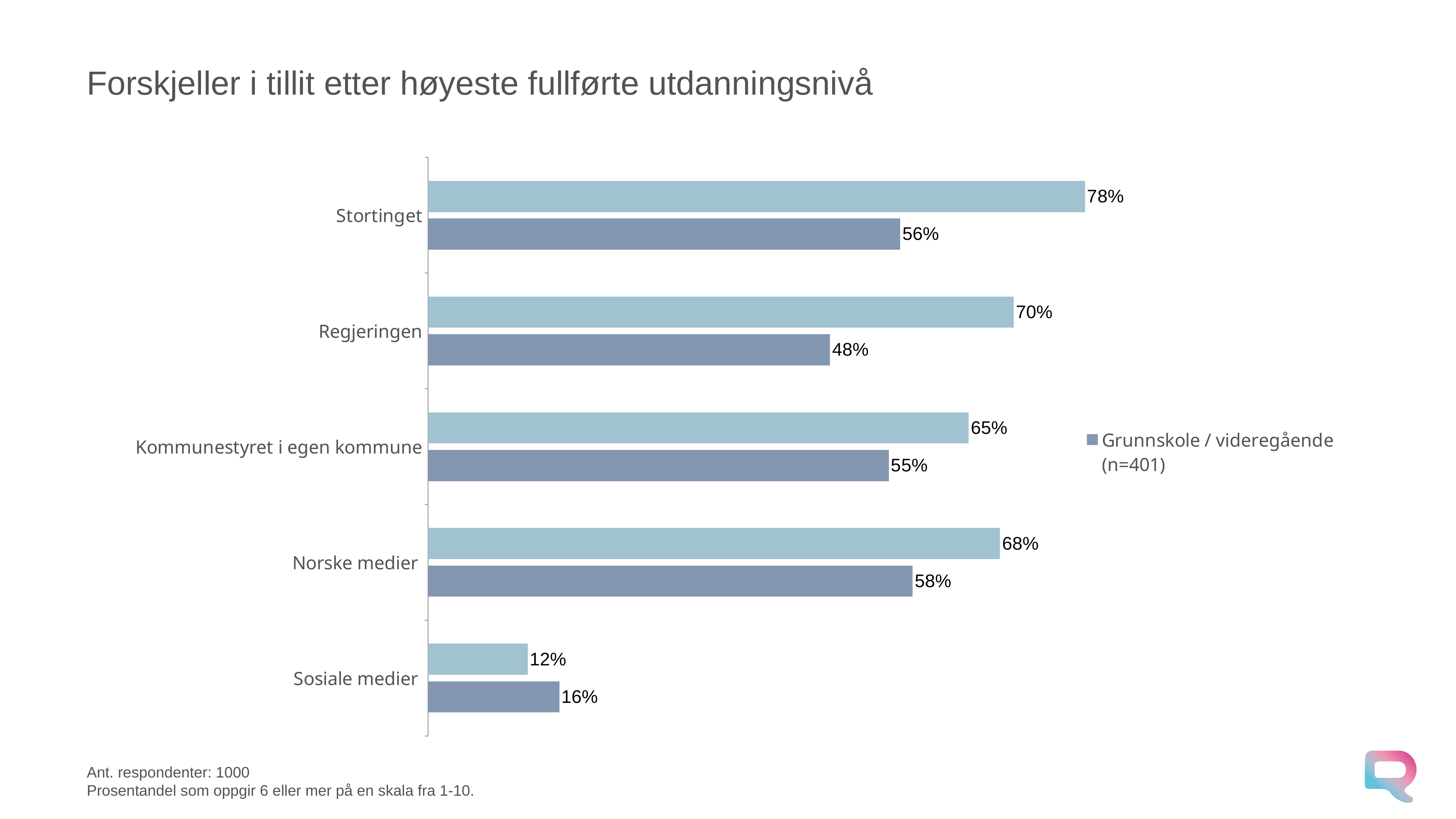
How many categories are shown on the chart? 5 Which category has the lowest value in the Grunnskole / videregående (n=401) series? Sosiale medier Which category has the highest value in the Grunnskole / videregående (n=401) series? Norske medier What value is printed on the lighter blue bar for Stortinget? 78% What is the difference between the Grunnskole / videregående values for Stortinget and Regjeringen? 8% How many series does the legend list? 1 What is the value for Regjeringen in the Grunnskole / videregående (n=401) series? 48% What is the title of the slide? Forskjeller i tillit etter høyeste fullførte utdanningsnivå What kind of chart is shown on the slide? Bar chart What is the value for Sosiale medier in the Grunnskole / videregående (n=401) series? 16% In the Grunnskole / videregående series, which is larger: Norske medier or Kommunestyret i egen kommune? Norske medier What is the value for Stortinget in the Grunnskole / videregående (n=401) series? 56%